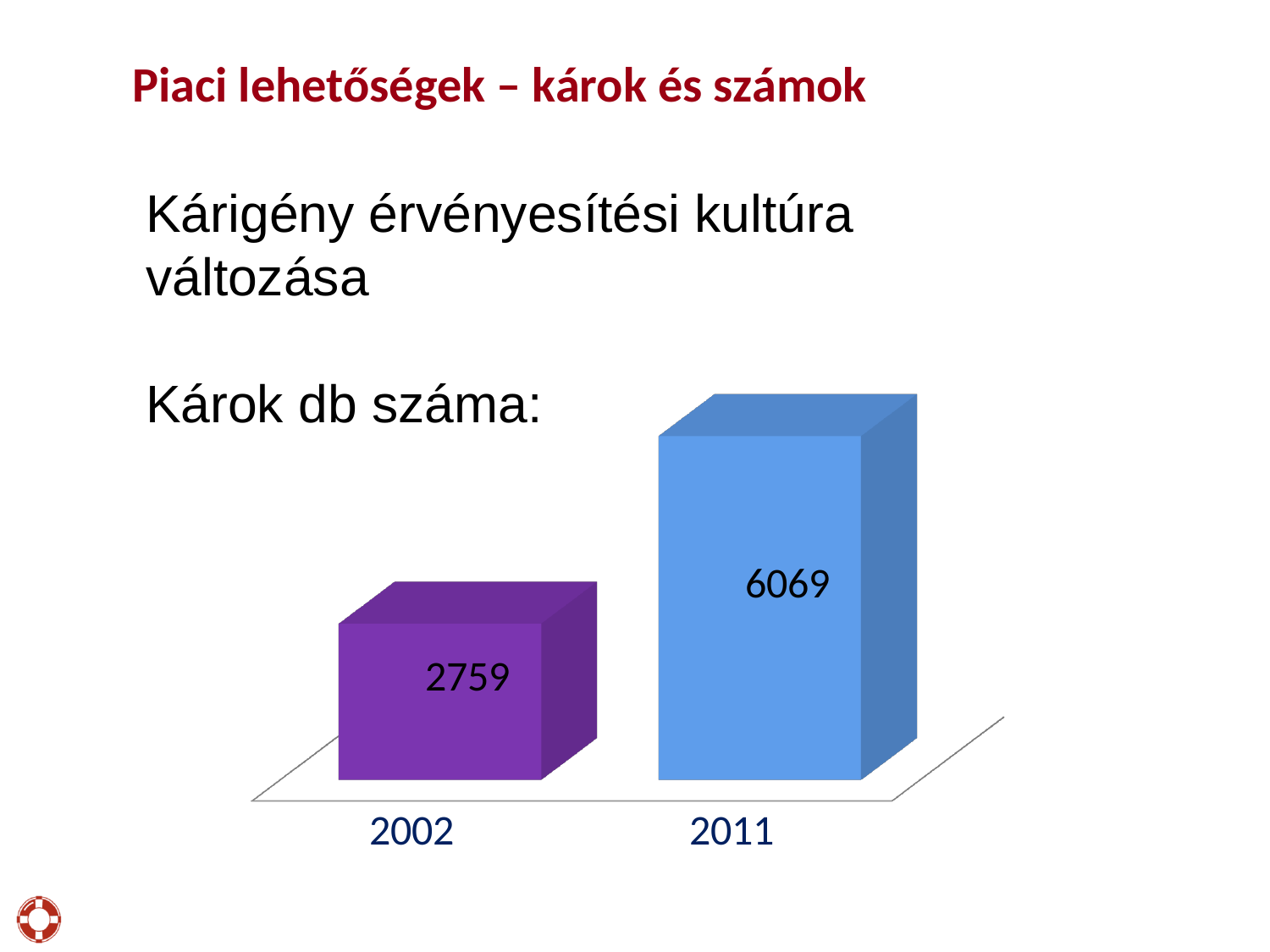
What kind of chart is shown on the slide? bar chart What is the value shown for 2011? 6069 Do the values rise or fall from 2002 to 2011? rise Which year has the lower value? 2002 What colour is the bar for 2011? blue How many categories are shown on the x axis? 2 What is the difference between the values for 2011 and 2002? 3310 Is the value for 2011 larger or smaller than the value for 2002? larger Which year has the higher value? 2011 What colour is the bar for 2002? purple What is the value shown for 2002? 2759